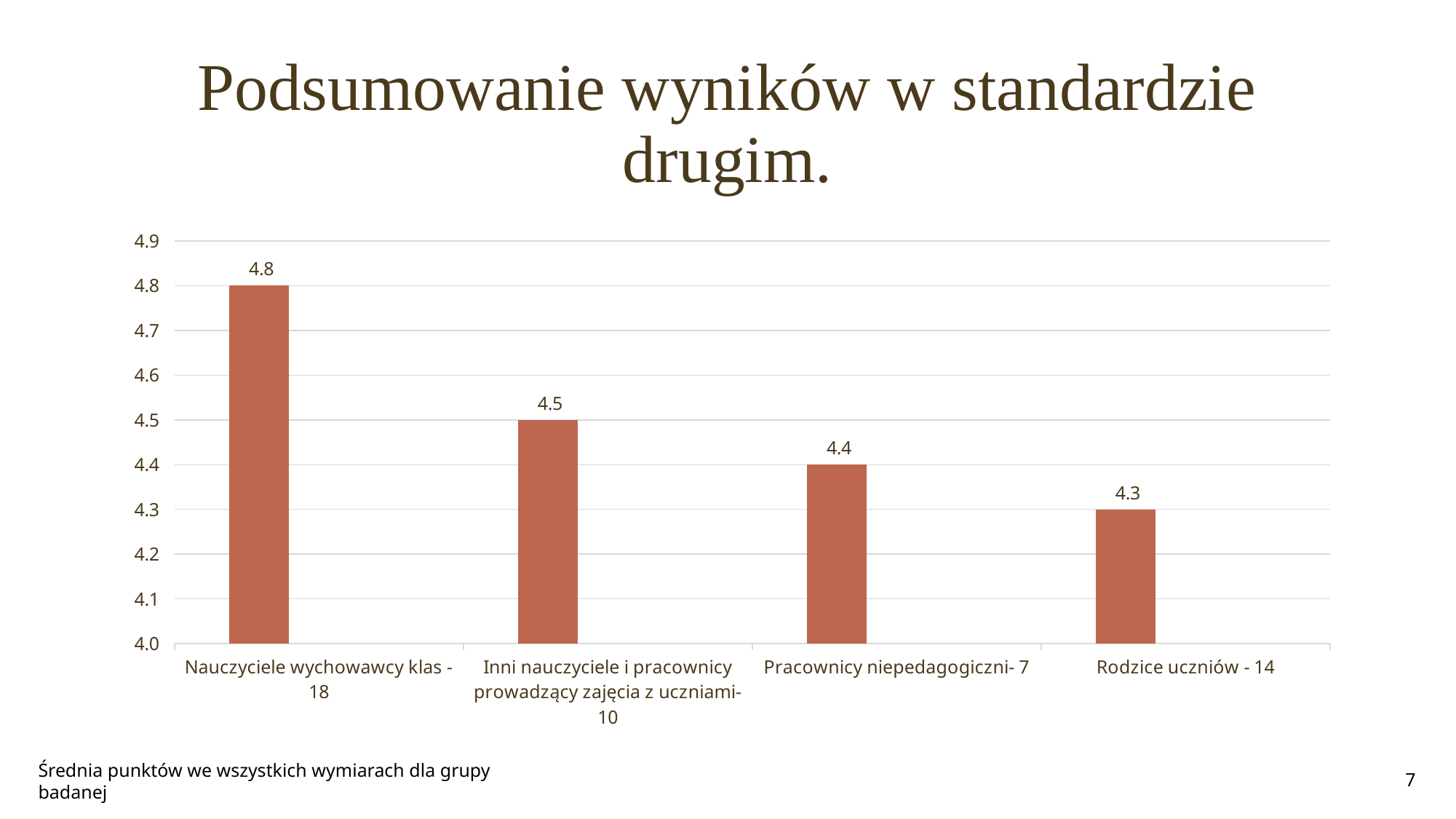
Do the values rise or fall from left to right along the x axis? Fall What is the difference between the values for "Nauczyciele wychowawcy klas - 18" and "Rodzice uczniów - 14"? 0.5 How many categories are shown in the chart? 4 What is the value for "Inni nauczyciele i pracownicy prowadzący zajęcia z uczniami- 10"? 4.5 Which category has the lowest value? Rodzice uczniów - 14 What is the value for "Rodzice uczniów - 14"? 4.3 Which category has the highest value? Nauczyciele wychowawcy klas - 18 What is the value for "Nauczyciele wychowawcy klas - 18"? 4.8 What is the title of the slide containing the chart? Podsumowanie wyników w standardzie drugim. What kind of chart is shown on the slide? Bar chart What is the value for "Pracownicy niepedagogiczni- 7"? 4.4 Which is larger: the value for "Inni nauczyciele i pracownicy prowadzący zajęcia z uczniami- 10" or for "Pracownicy niepedagogiczni- 7"? Inni nauczyciele i pracownicy prowadzący zajęcia z uczniami- 10